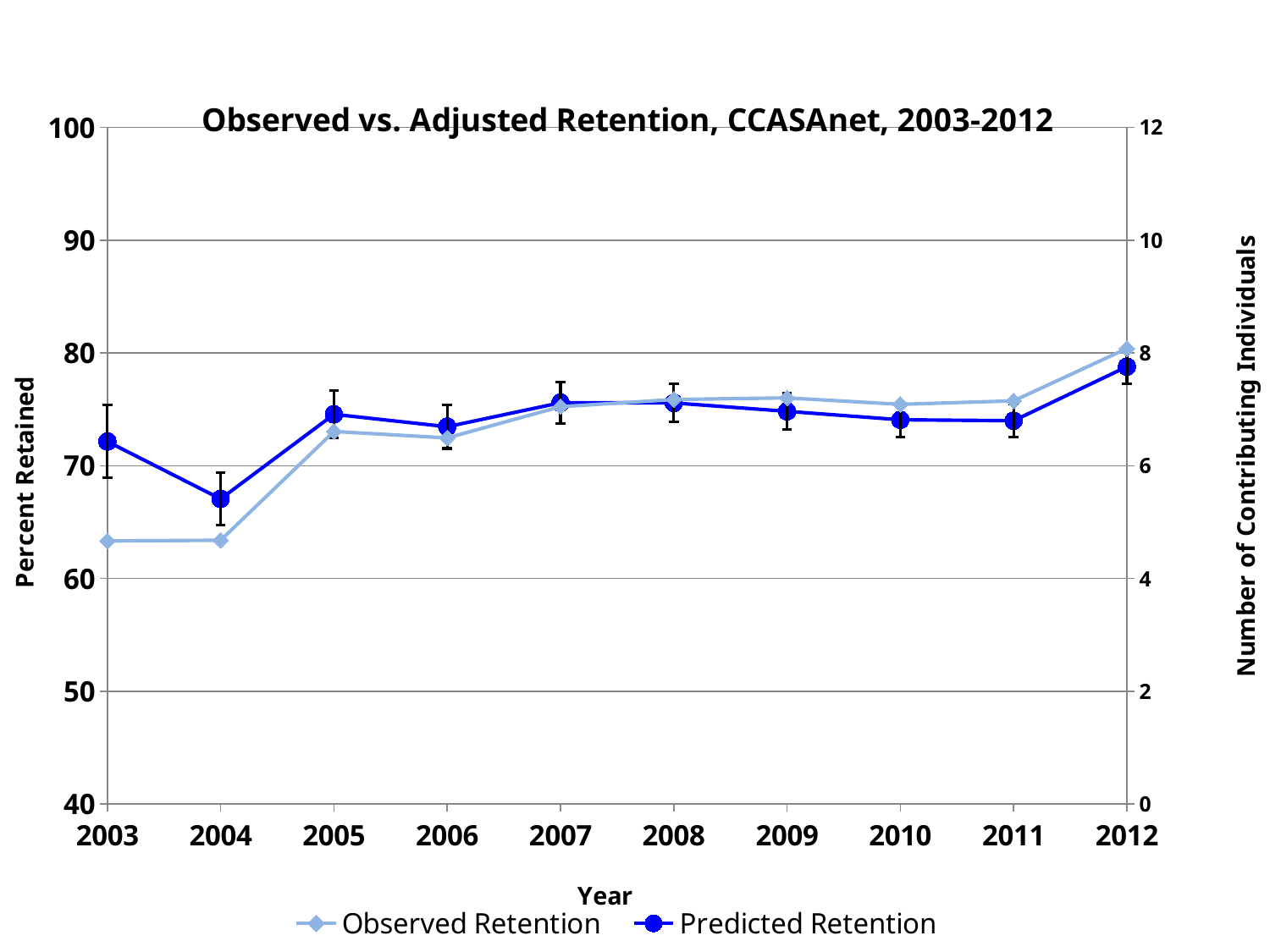
In which year is Observed Retention highest? 2012 Is the Predicted Retention value for 2012 greater or less than 70? greater In which year is Predicted Retention lowest? 2004 What is the label of the left vertical axis? Percent Retained What is the title of the chart? Observed vs. Adjusted Retention, CCASAnet, 2003-2012 In 2003, which is larger: Observed Retention or Predicted Retention? Predicted Retention Is the Observed Retention value for 2003 greater or less than 70? less How many series does the legend list? 2 In which year is Predicted Retention highest? 2012 How many years are plotted along the x axis? 10 What kind of chart is shown on the slide? Line chart Does Predicted Retention rise or fall from 2003 to 2004? Fall